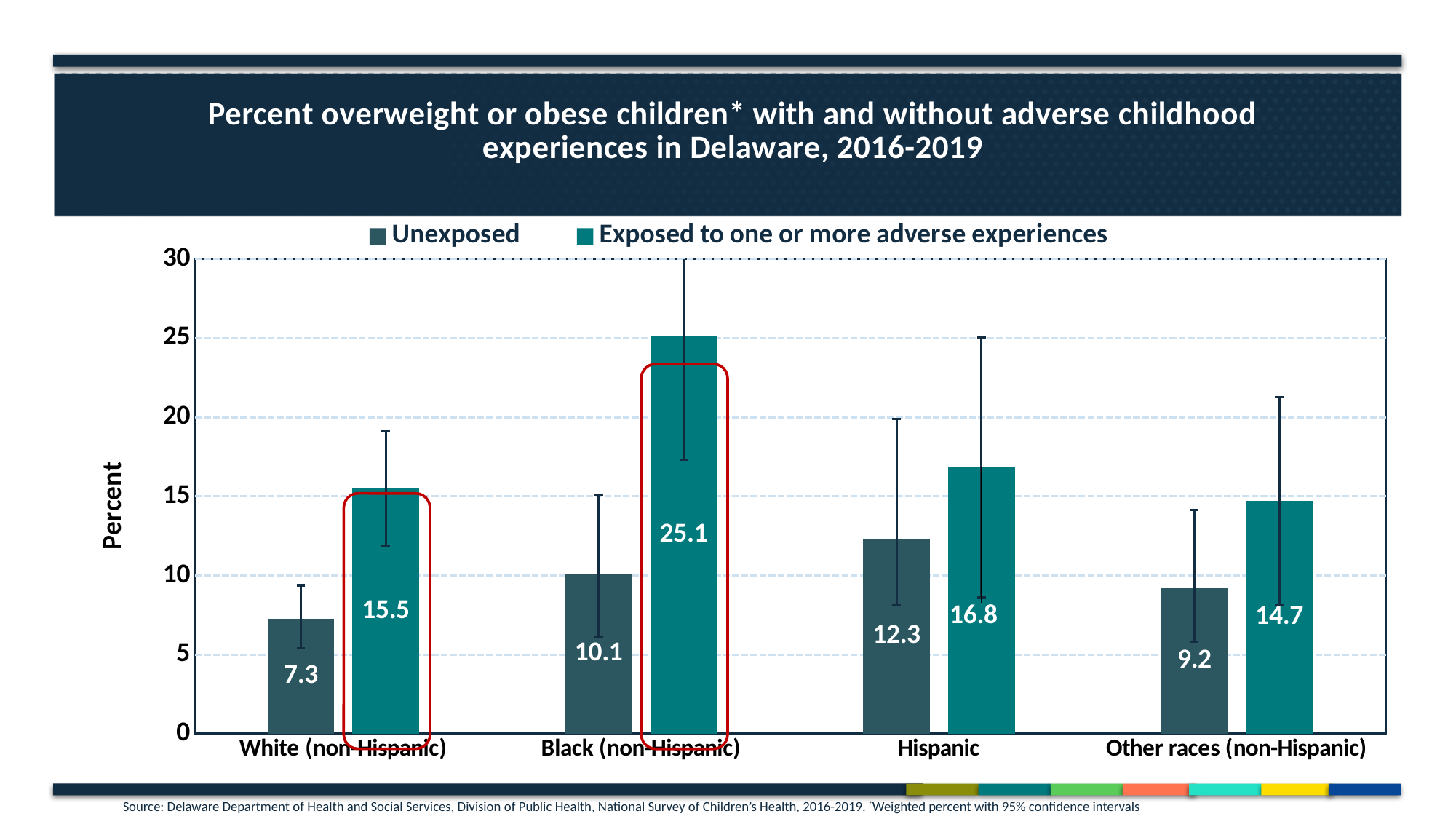
What is the label on the y axis? Percent What is the value for Unexposed children in the Hispanic group? 12.3 What kind of chart is shown on the slide? Bar chart What is the difference between the Exposed and Unexposed values for the Black (non-Hispanic) group? 15.0 Which racial/ethnic group has the lowest value for Unexposed children? White (non-Hispanic) What is the value for children Exposed to one or more adverse experiences in the Other races (non-Hispanic) group? 14.7 What is the value for Unexposed children in the White (non-Hispanic) group? 7.3 Which racial/ethnic group has the highest value for children Exposed to one or more adverse experiences? Black (non-Hispanic) Which is larger: the Unexposed value for Hispanic children or the Unexposed value for Other races (non-Hispanic) children? Hispanic How many series does the legend list? 2 What is the value for children Exposed to one or more adverse experiences in the Black (non-Hispanic) group? 25.1 How many racial/ethnic groups are shown on the x axis? 4